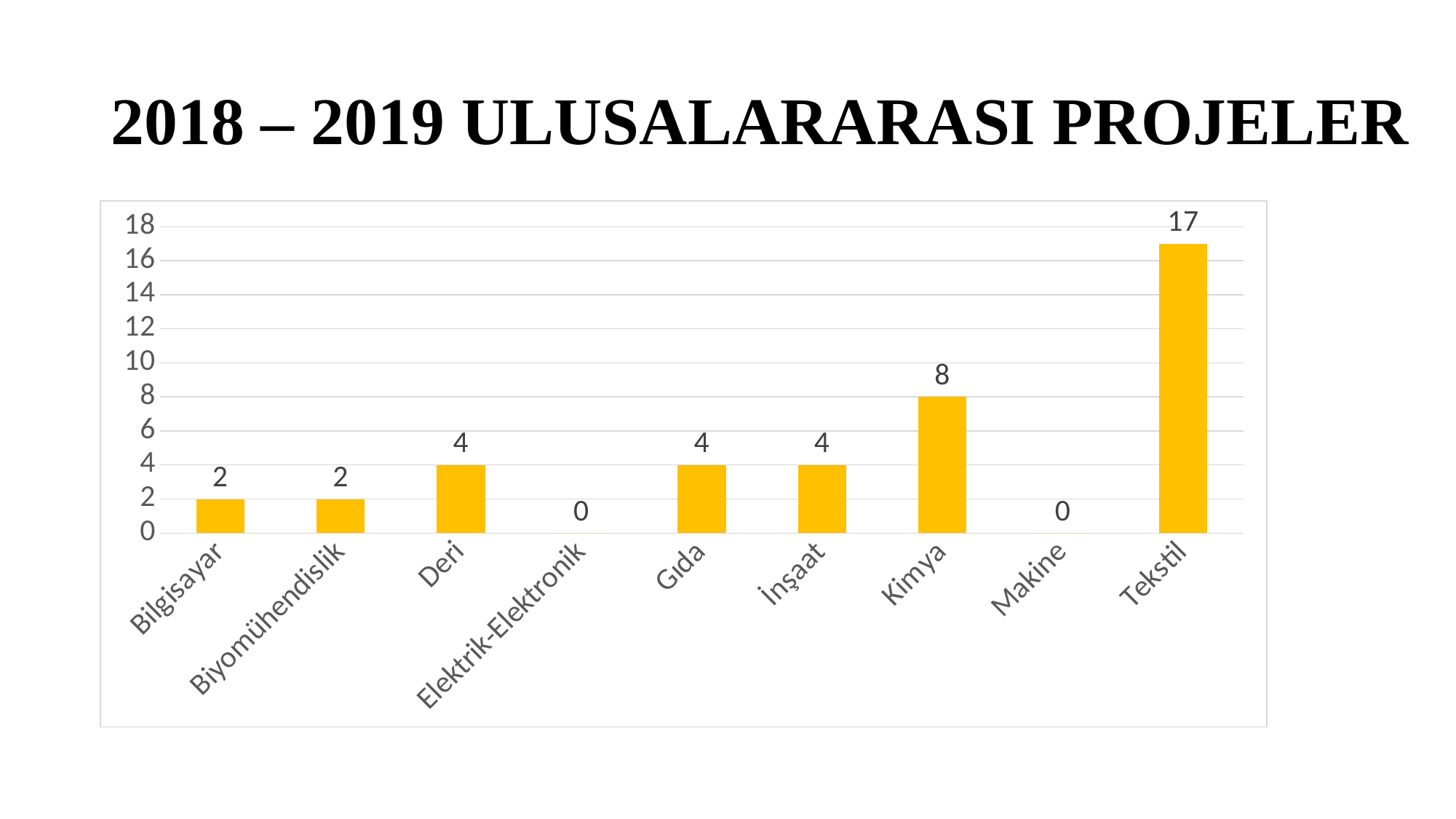
What is the title of the slide? 2018 – 2019 ULUSALARARASI PROJELER What is the difference between the values for Tekstil and Kimya? 9 What is the value for Kimya? 8 What is the difference between the values for Deri and Biyomühendislik? 2 Which is larger, the value for Kimya or the value for Gıda? Kimya How many categories have a value of 0? 2 What is the value for Bilgisayar? 2 What is the value for Tekstil? 17 How many categories are shown on the x axis? 9 What kind of chart is shown on the slide? Bar chart What is the value for Elektrik-Elektronik? 0 Which category has the highest value? Tekstil